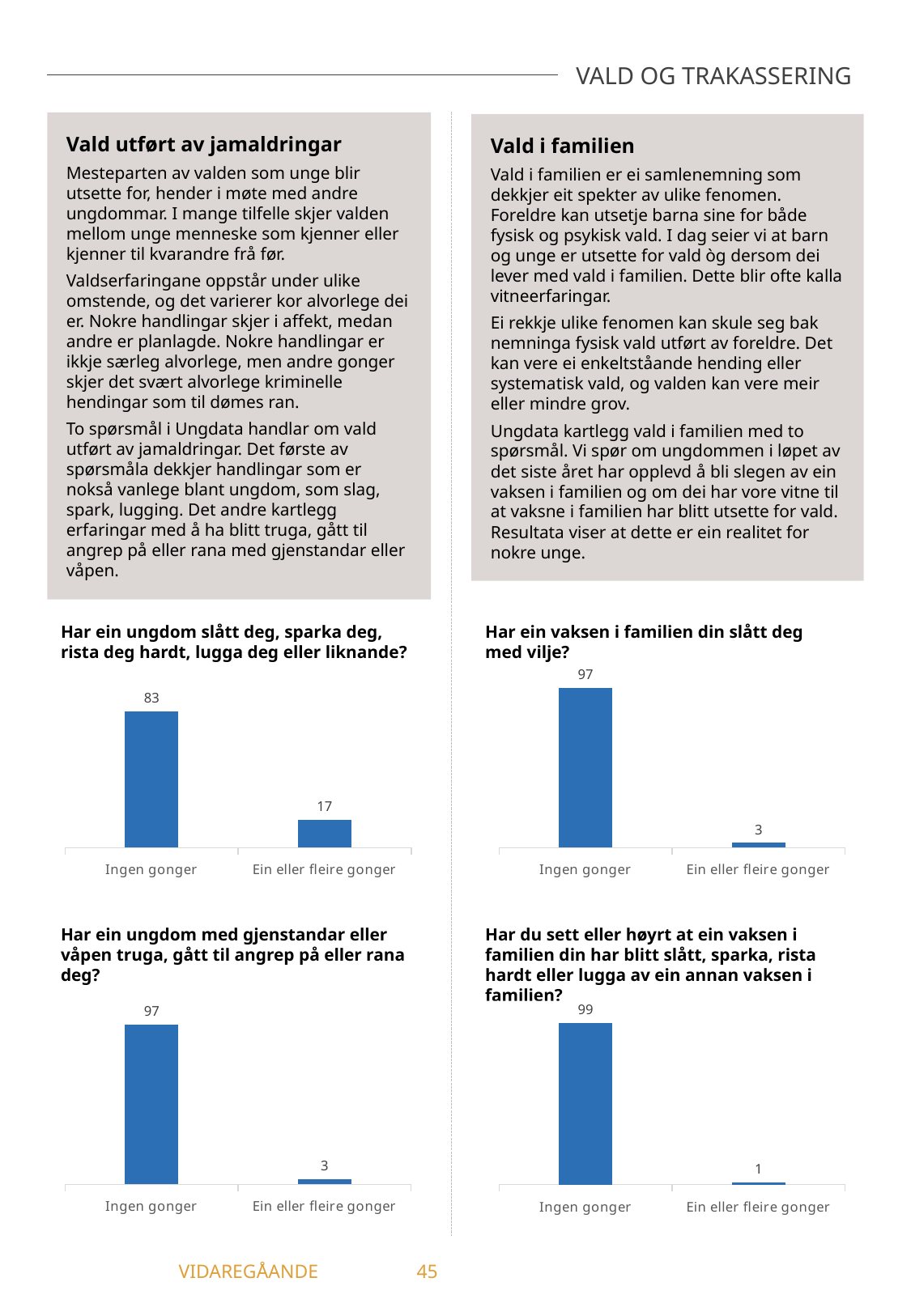
In the bottom-left chart ("Har ein ungdom med gjenstandar eller våpen truga, gått til angrep på eller rana deg?"), what is the value for "Ingen gonger"? 97 In the top-right chart ("Har ein vaksen i familien din slått deg med vilje?"), which category has the lowest value? Ein eller fleire gonger In the top-right chart ("Har ein vaksen i familien din slått deg med vilje?"), what is the value for "Ein eller fleire gonger"? 3 How many categories does the top-left chart ("Har ein ungdom slått deg, sparka deg, rista deg hardt, lugga deg eller liknande?") show? 2 In the top-left chart ("Har ein ungdom slått deg, sparka deg, rista deg hardt, lugga deg eller liknande?"), what is the value for "Ein eller fleire gonger"? 17 What kind of chart is the bottom-right chart ("Har du sett eller høyrt at ein vaksen i familien din har blitt slått...")? Bar chart In the bottom-left chart ("Har ein ungdom med gjenstandar eller våpen truga, gått til angrep på eller rana deg?"), which is larger: "Ingen gonger" or "Ein eller fleire gonger"? Ingen gonger In the top-left chart ("Har ein ungdom slått deg, sparka deg, rista deg hardt, lugga deg eller liknande?"), what is the value for "Ingen gonger"? 83 In the top-left chart ("Har ein ungdom slått deg, sparka deg, rista deg hardt, lugga deg eller liknande?"), what is the difference between "Ingen gonger" and "Ein eller fleire gonger"? 66 How many charts are shown on the slide? 4 In the bottom-right chart ("Har du sett eller høyrt at ein vaksen i familien din har blitt slått..."), which category has the highest value? Ingen gonger In the bottom-right chart ("Har du sett eller høyrt at ein vaksen i familien din har blitt slått..."), what is the value for "Ein eller fleire gonger"? 1